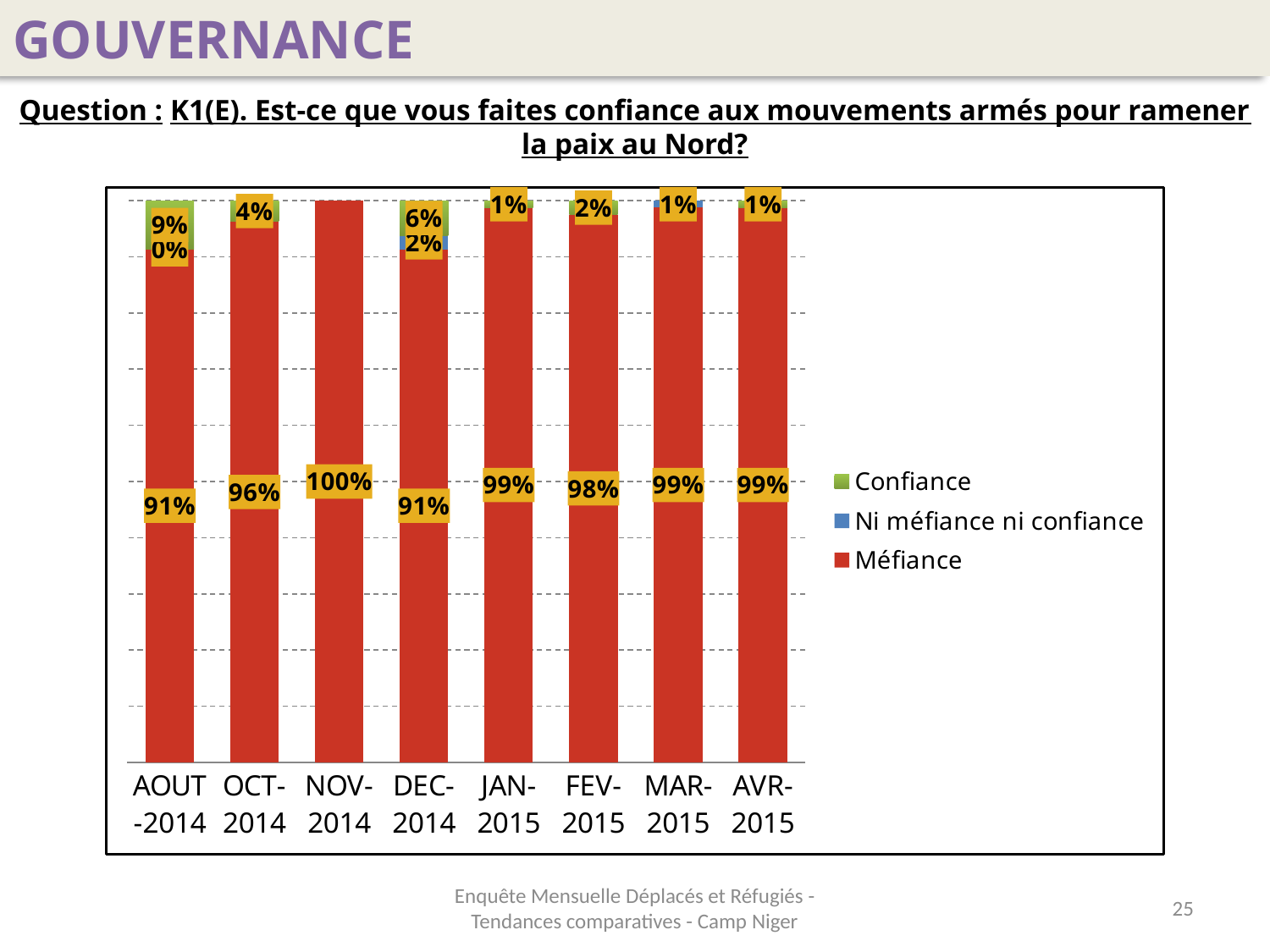
In which month is the Confiance value highest? AOUT-2014 In which month is the Méfiance value highest? NOV-2014 How many series does the legend list? 3 What kind of chart is shown on the slide? Stacked bar chart What is the value for Confiance in DEC-2014? 6% Which has a larger Méfiance value, FEV-2015 or OCT-2014? FEV-2015 What is the value for Méfiance in NOV-2014? 100% What is the difference between the Méfiance value in OCT-2014 and in AOUT-2014? 5 percentage points What is the value for Ni méfiance ni confiance in DEC-2014? 2% What is the value for Méfiance in AOUT-2014? 91% What is the value for Confiance in AOUT-2014? 9% How many months are shown on the x axis? 8